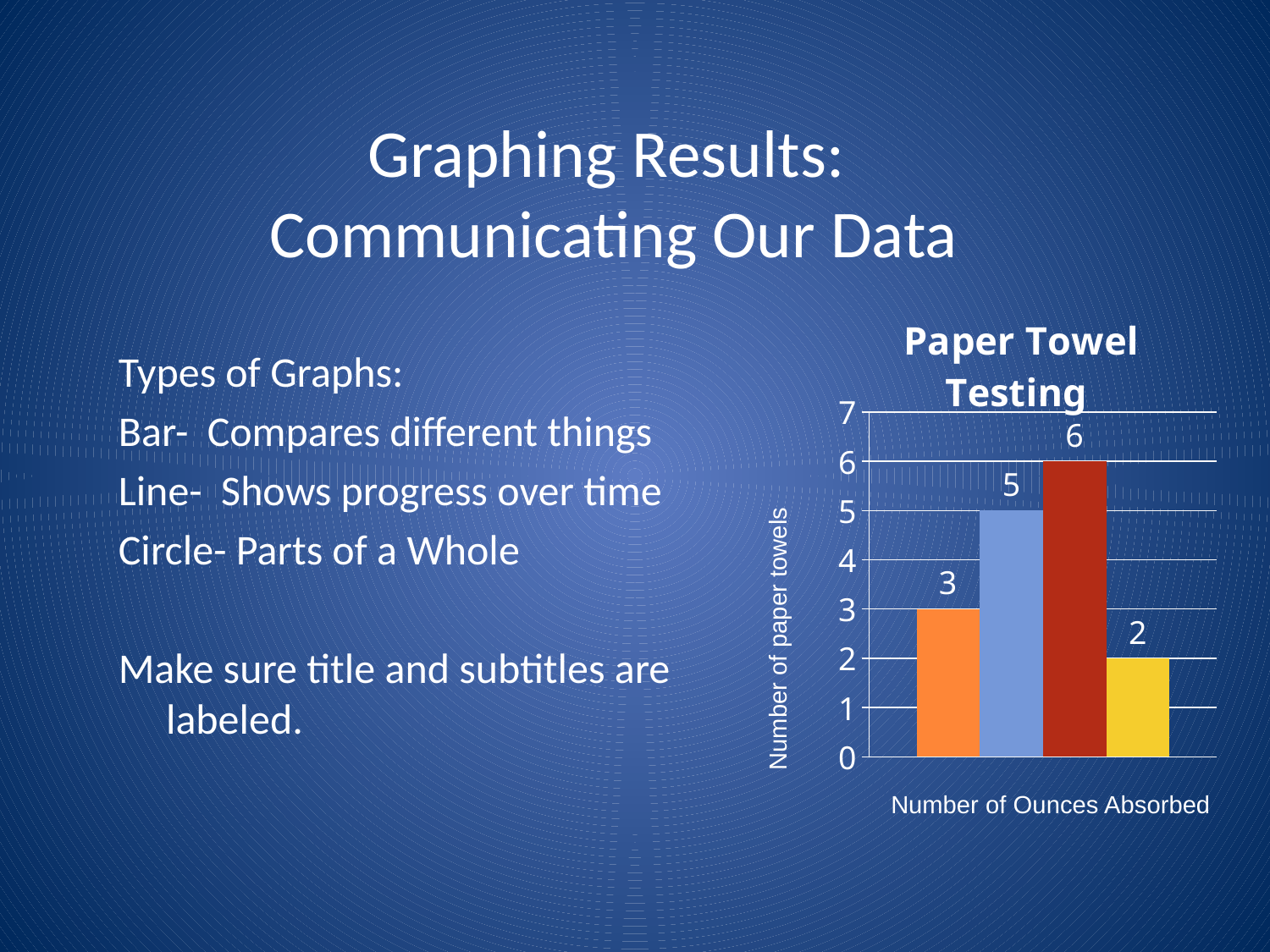
Which bar has the highest value in the Paper Towel Testing chart? the red bar (third from the left) What type of chart is shown on the slide? bar chart What is the value of the orange bar (first from the left) in the Paper Towel Testing chart? 3 What is the difference between the red bar and the yellow bar in the Paper Towel Testing chart? 4 Which is larger in the Paper Towel Testing chart, the orange bar or the light blue bar? the light blue bar What is the label on the vertical axis of the Paper Towel Testing chart? Number of paper towels What is the title of the chart? Paper Towel Testing What is the value of the yellow bar (fourth from the left) in the Paper Towel Testing chart? 2 How many bars are plotted in the Paper Towel Testing chart? 4 Which bar has the lowest value in the Paper Towel Testing chart? the yellow bar (fourth from the left) What is the value of the light blue bar (second from the left) in the Paper Towel Testing chart? 5 What is the value of the red bar (third from the left) in the Paper Towel Testing chart? 6